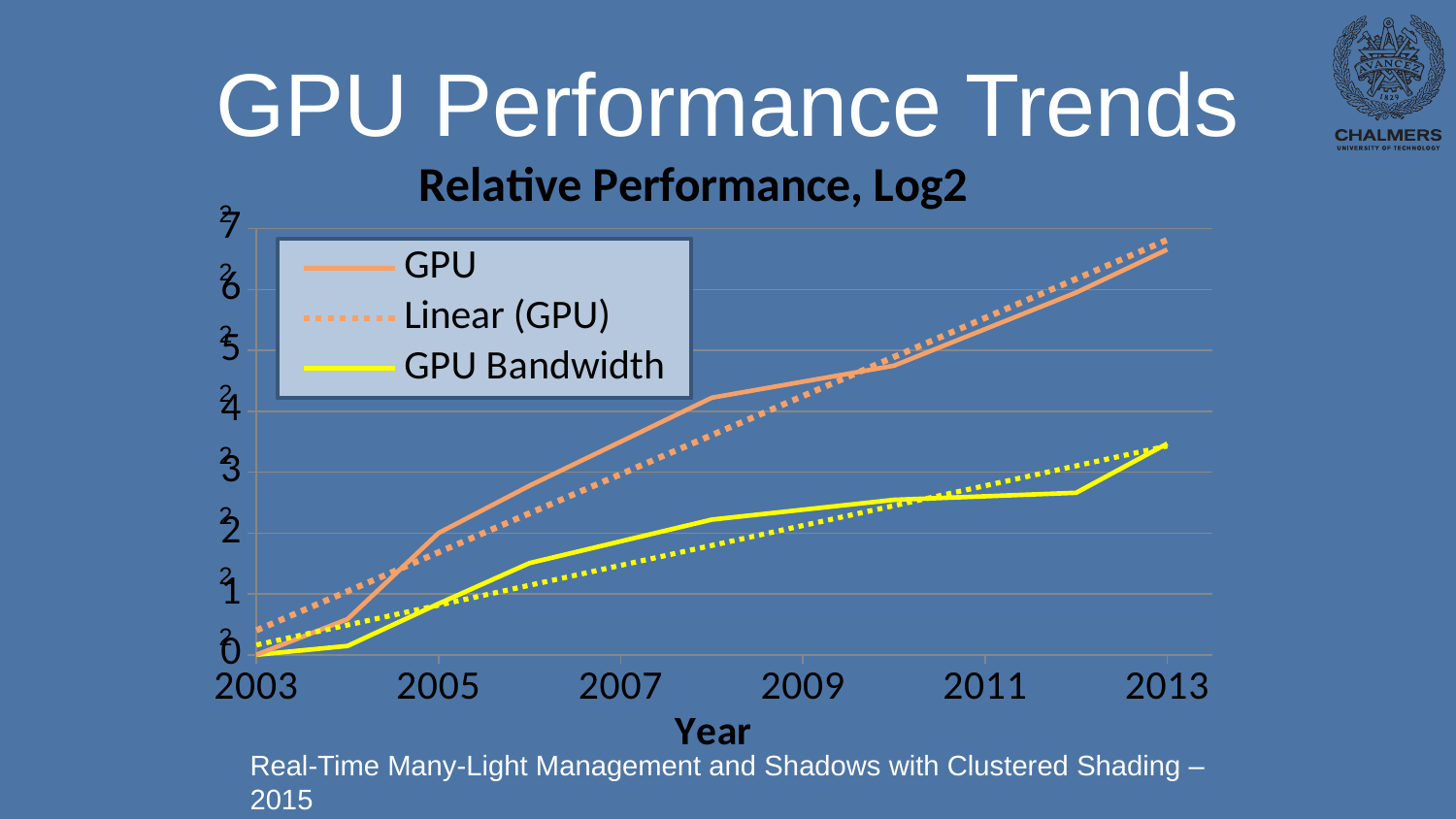
How many series does the chart legend list? 3 Is the value of the GPU series in 2013 greater or less than 6? greater What kind of chart is shown on the slide? line chart Is the value of the GPU series in 2009 greater or less than 4? greater Is the value of the GPU Bandwidth series in 2011 greater or less than 3? less Does the GPU series rise or fall from 2003 to 2013? rise Does the GPU Bandwidth series rise or fall from 2003 to 2013? rise What is the label of the x axis? Year What is the title of the chart? Relative Performance, Log2 In 2013, which series has the higher value, GPU or GPU Bandwidth? GPU How many year labels are shown on the x axis? 6